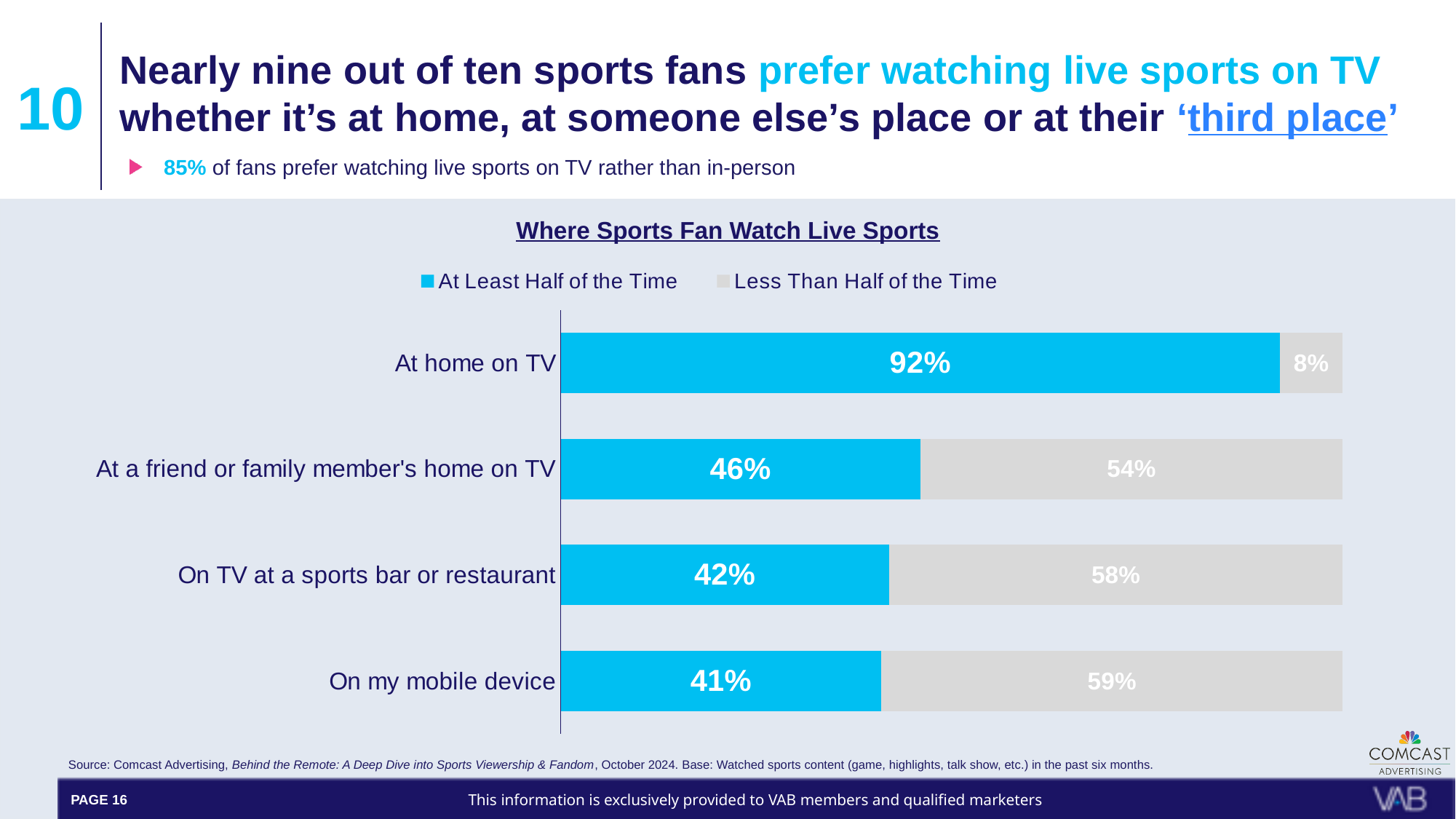
Which category has the highest 'At Least Half of the Time' value? At home on TV What percentage of sports fans watch live sports at home on TV at least half of the time? 92% How many series does the legend list? 2 What is the 'At Least Half of the Time' value for 'On my mobile device'? 41% What is the 'Less Than Half of the Time' value for 'At a friend or family member's home on TV'? 54% What is the title of the chart? Where Sports Fan Watch Live Sports What is the total of the stacked bar for 'On TV at a sports bar or restaurant'? 100% Which category has the lowest 'At Least Half of the Time' value? On my mobile device What is the difference between the 'At Least Half of the Time' values for 'At home on TV' and 'On TV at a sports bar or restaurant'? 50% How many categories are shown in the chart? 4 What kind of chart is shown on the slide? Stacked bar chart Which is larger: the 'At Least Half of the Time' value for 'At a friend or family member's home on TV' or for 'On TV at a sports bar or restaurant'? At a friend or family member's home on TV